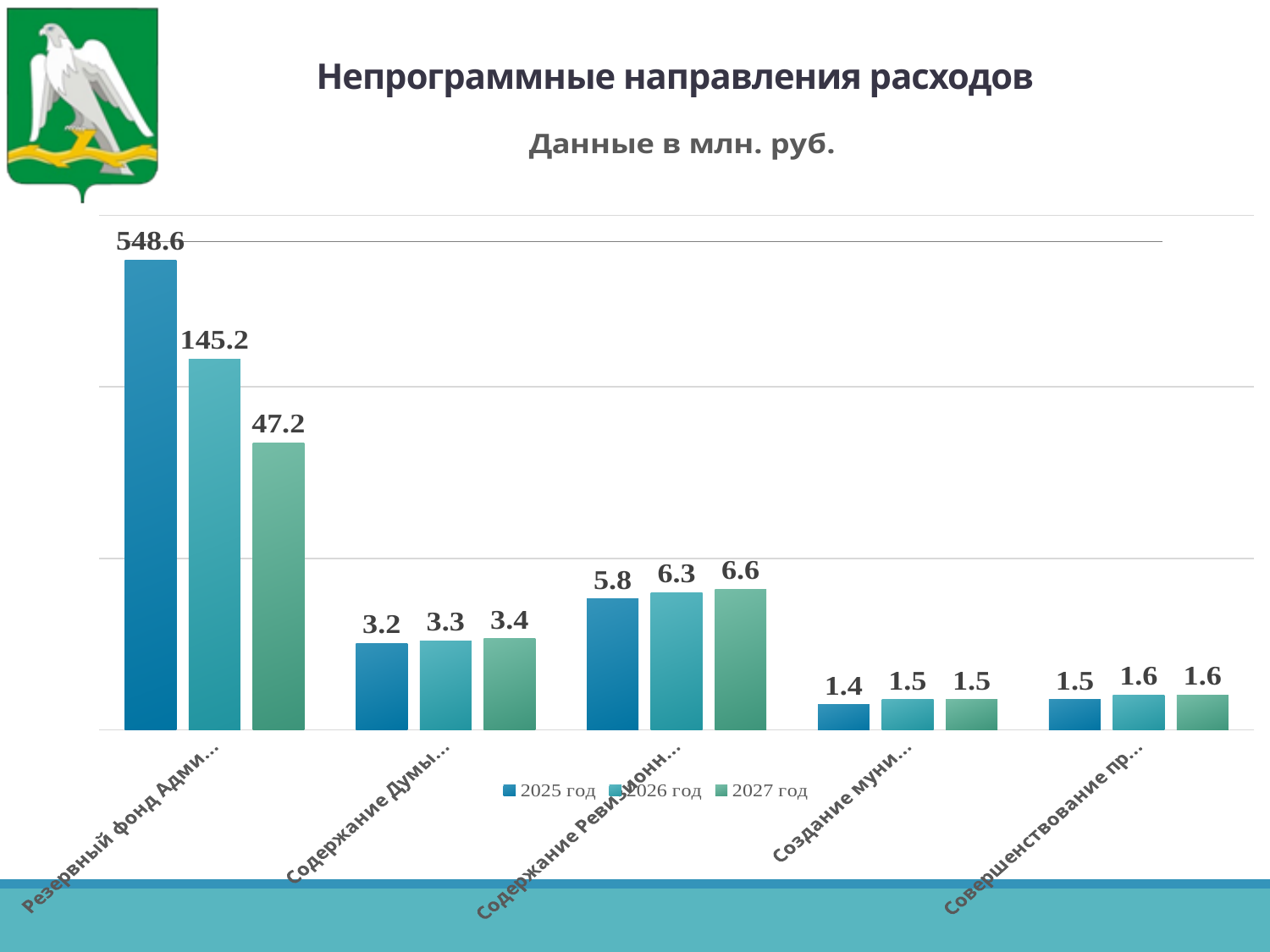
What is the value for 2027 год in the category beginning "Резервный фонд"? 47.2 What kind of chart is shown on the slide? bar chart Which is larger in the category beginning "Содержание Ревизионн": the value for 2025 год or for 2027 год? 2027 год How many categories are shown on the x axis? 5 What is the difference between the 2025 год and 2026 год values in the category beginning "Резервный фонд"? 403.4 What is the value for 2026 год in the category beginning "Содержание Ревизионн"? 6.3 Which category has the highest value for 2025 год? Резервный фонд Адми... What is the value for 2025 год in the category beginning "Создание муни"? 1.4 Which category has the lowest value for 2025 год? Создание муни... What unit of measurement is stated in the chart subtitle? млн. руб. How many series does the legend list? 3 What is the value for 2025 год in the category beginning "Резервный фонд"? 548.6